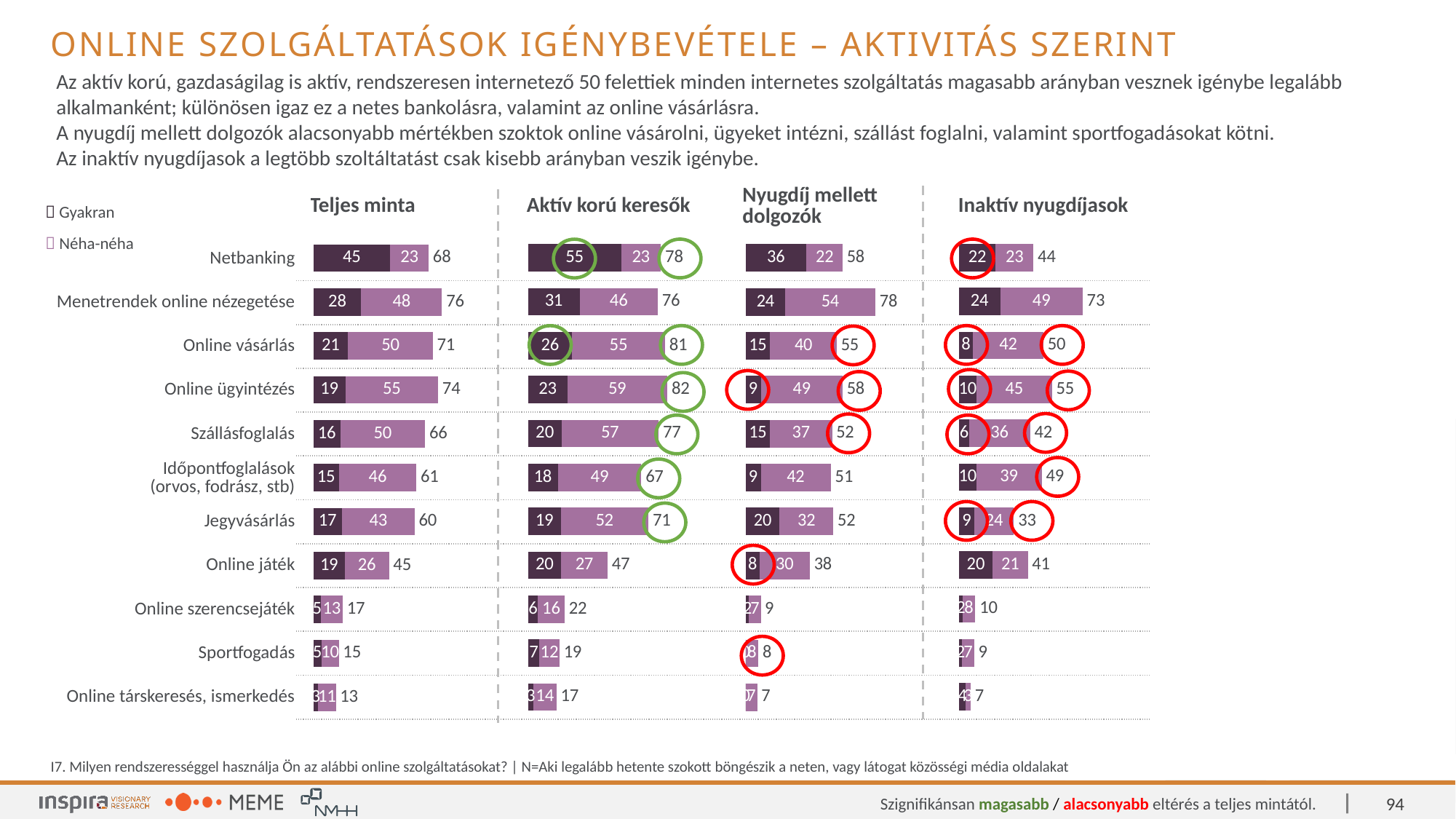
For Online vásárlás, which chart shows a higher total: Nyugdíj mellett dolgozók or Inaktív nyugdíjasok? Nyugdíj mellett dolgozók Which series is shown in the dark purple segments of the bars? Gyakran How many service categories are listed in each chart? 11 What kind of chart is used on this slide? Stacked bar chart How many series does the legend list? 2 In the Teljes minta chart, which category has the highest total? Menetrendek online nézegetése In the Teljes minta chart, what is the Gyakran value for Netbanking? 45 In the Inaktív nyugdíjasok chart, what is the total shown for Jegyvásárlás? 33 In the Nyugdíj mellett dolgozók chart, what is the Néha-néha value for Menetrendek online nézegetése? 54 In the Aktív korú keresők chart, what is the total shown for Online vásárlás? 81 In the Aktív korú keresők chart, what is the difference between the totals for Netbanking and Online játék? 31 In the Inaktív nyugdíjasok chart, which category has the lowest total? Online társkeresés, ismerkedés